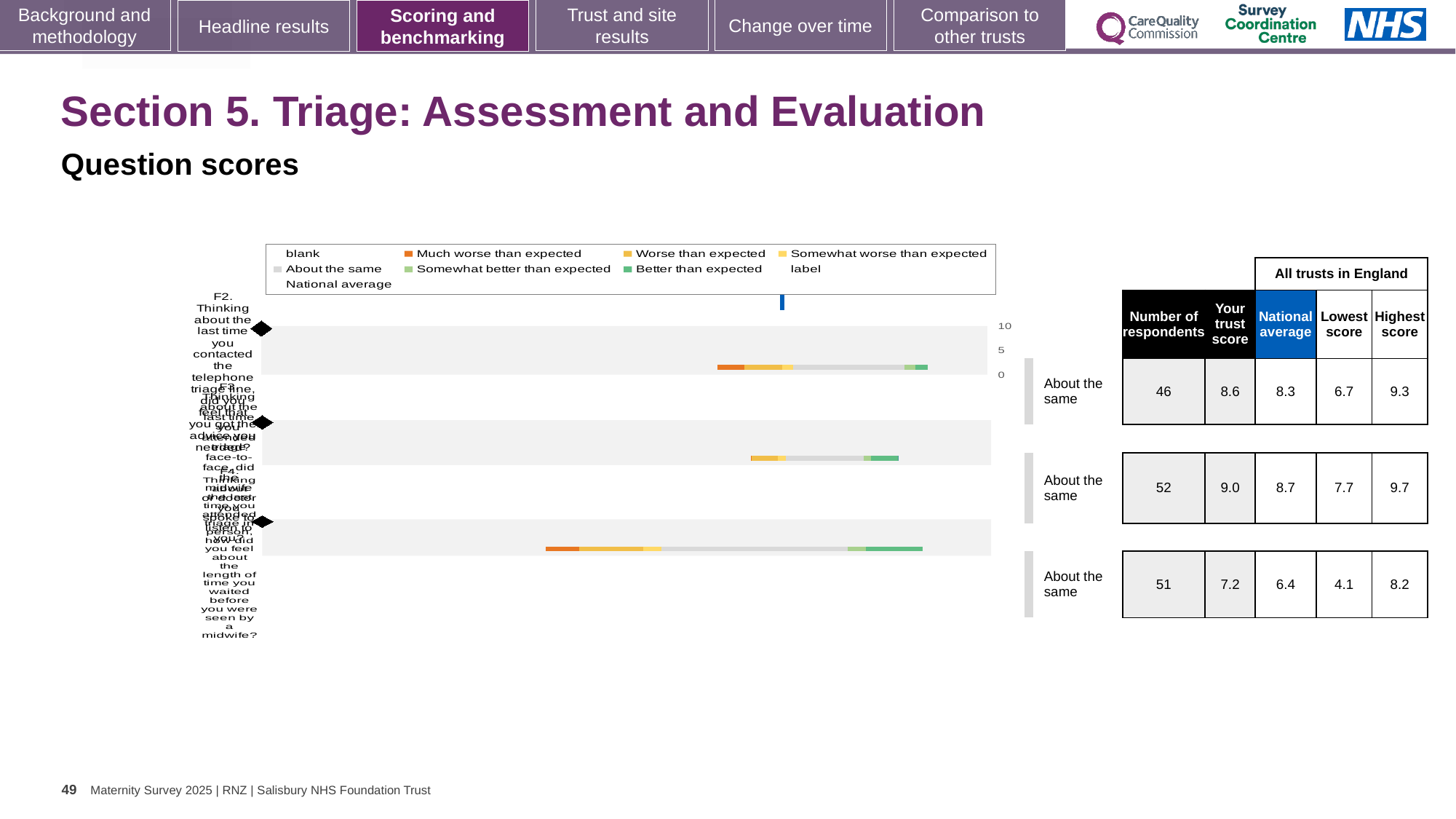
How many questions (categories) are plotted in the chart? 3 What type of chart is shown on the slide? bar chart What colour does the chart legend use for 'Much worse than expected'? orange In the table beside the chart, what is the difference between the trust score and the national average for question F2? 0.3 In the table beside the chart, what is the lowest score among all trusts in England for question F4? 4.1 In the table beside the chart, which question has the highest 'Your trust score'? F3 In the table beside the chart, what is the national average for question F4? 6.4 In the table beside the chart, how many respondents answered question F3? 52 What colour does the chart legend use for 'Better than expected'? green In the table beside the chart, which question has the lowest national average? F4 In the table beside the chart, what is the 'Your trust score' for question F2? 8.6 In the table beside the chart, is the trust score for F3 higher or lower than the national average for F3? higher